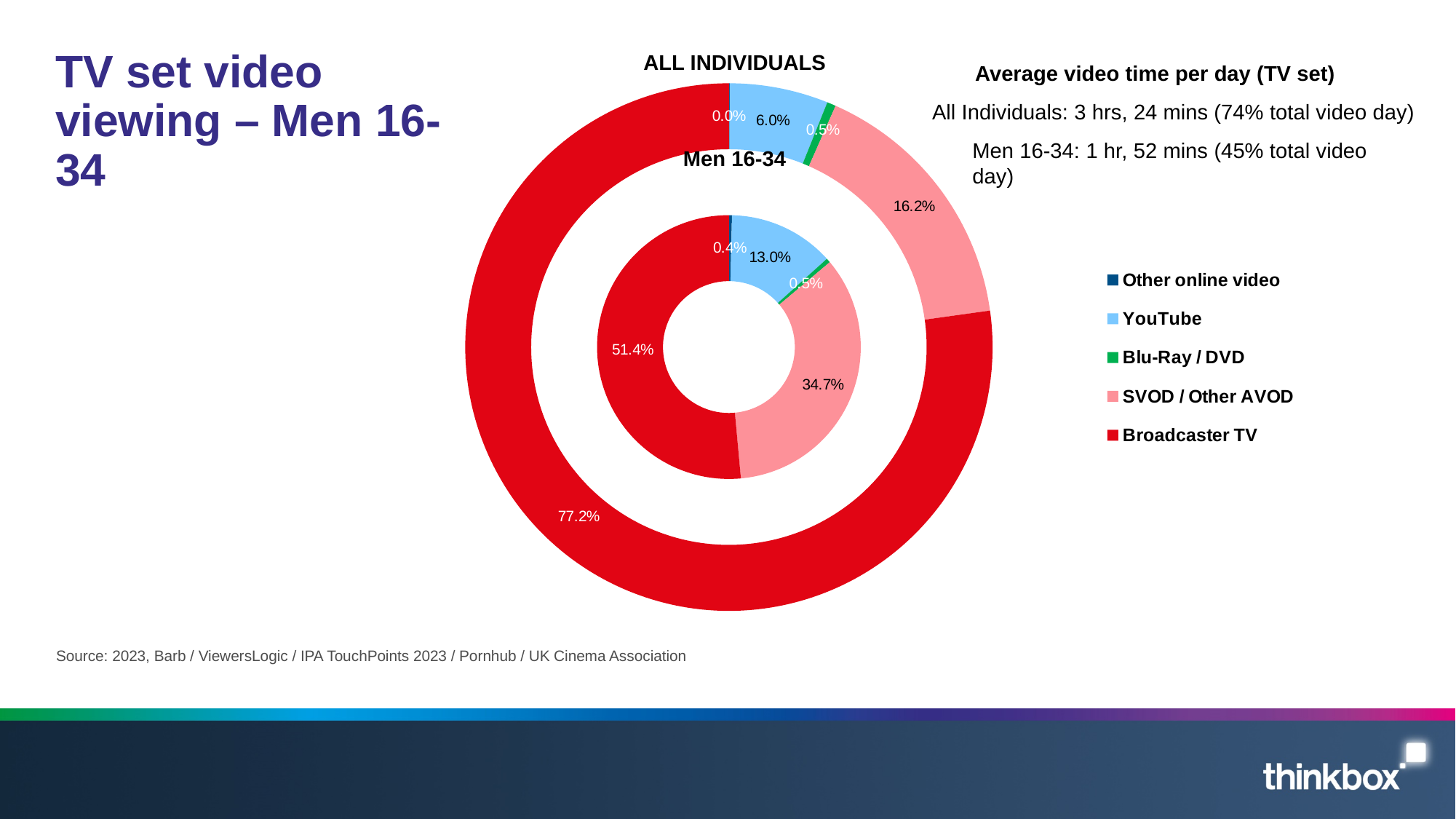
What share of TV set video viewing does Broadcaster TV account for in the Men 16-34 (inner) ring? 51.4% Which ring has the larger YouTube share, All Individuals or Men 16-34? Men 16-34 Which category has the largest share in the Men 16-34 ring? Broadcaster TV What is the SVOD / Other AVOD share in the All Individuals ring? 16.2% What type of chart is shown on the slide? Doughnut chart Which colour represents Blu-Ray / DVD in the chart? Green How much larger is the SVOD / Other AVOD share for Men 16-34 than for All Individuals? 18.5 percentage points How many categories does the legend list? 5 What is the YouTube share in the Men 16-34 ring? 13.0% What share of TV set video viewing does Broadcaster TV account for in the All Individuals (outer) ring? 77.2% Which category has the smallest share in the All Individuals ring? Other online video What is the Other online video share in the Men 16-34 ring? 0.4%